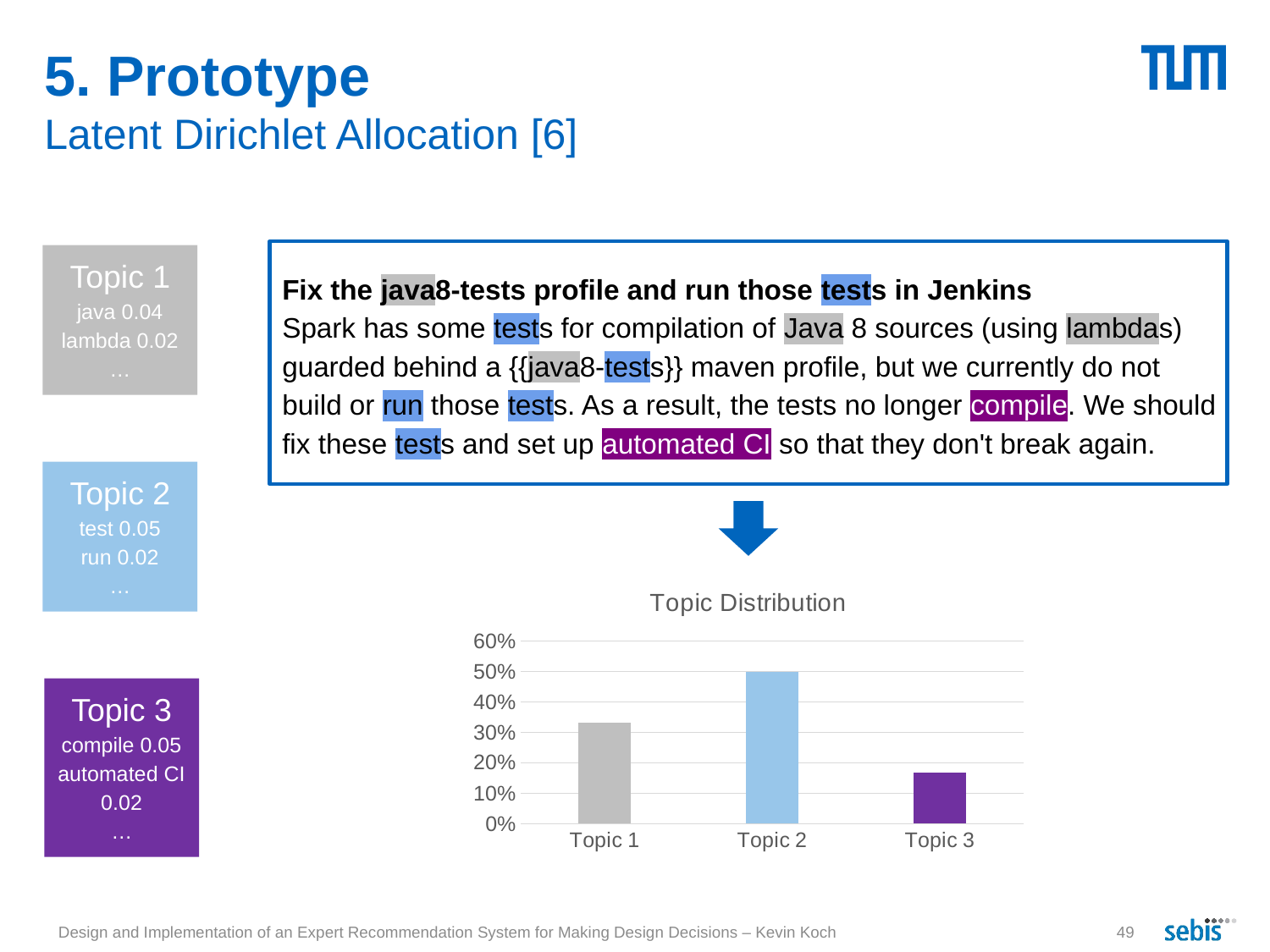
Is the value for Topic 3 greater or less than 20%? less Is the value for Topic 1 greater or less than 40%? less What is the highest value shown on the y axis of the Topic Distribution chart? 60% What is the value for Topic 2 in the Topic Distribution chart? 50% What kind of chart is the Topic Distribution chart? bar chart Which topic has the highest value in the Topic Distribution chart? Topic 2 Which topic has the lowest value in the Topic Distribution chart? Topic 3 How many topics are shown on the x axis of the Topic Distribution chart? 3 What is the title of the chart on the slide? Topic Distribution Is the value for Topic 3 greater or less than 10%? greater Which is larger in the Topic Distribution chart, Topic 1 or Topic 3? Topic 1